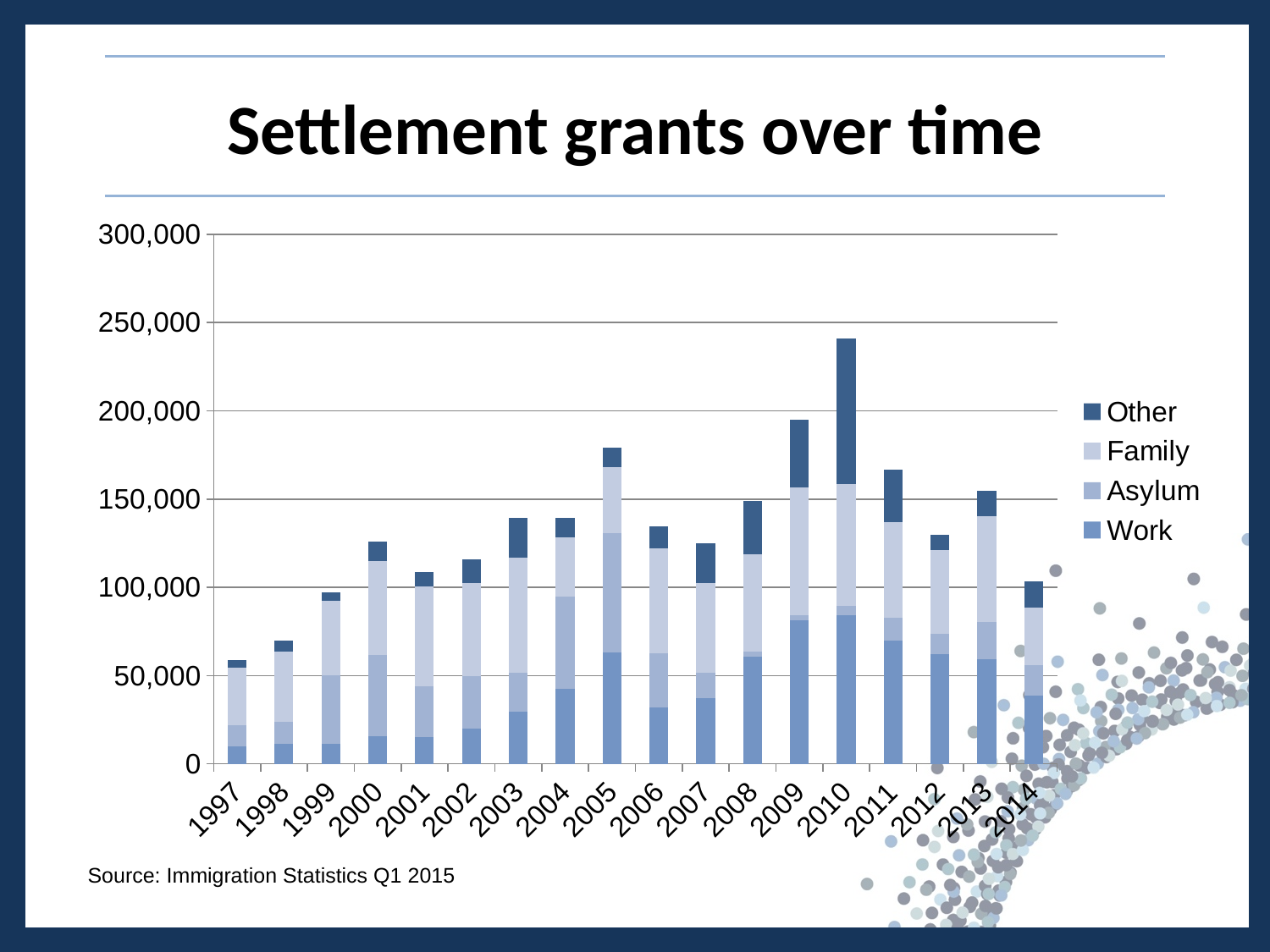
How many series does the legend list? 4 What kind of chart is shown on the slide? Stacked bar chart Is the total for 1997 greater or less than 100,000? less Which year has the highest total of settlement grants? 2010 Is the total for 2010 greater or less than 200,000? greater What is the title of the chart? Settlement grants over time How many years are shown on the x axis? 18 Is the total for 2012 greater or less than 150,000? less Do the totals rise or fall from 1997 to 2000? rise Which year has the lowest total of settlement grants? 1997 Which year has a larger total, 2009 or 2010? 2010